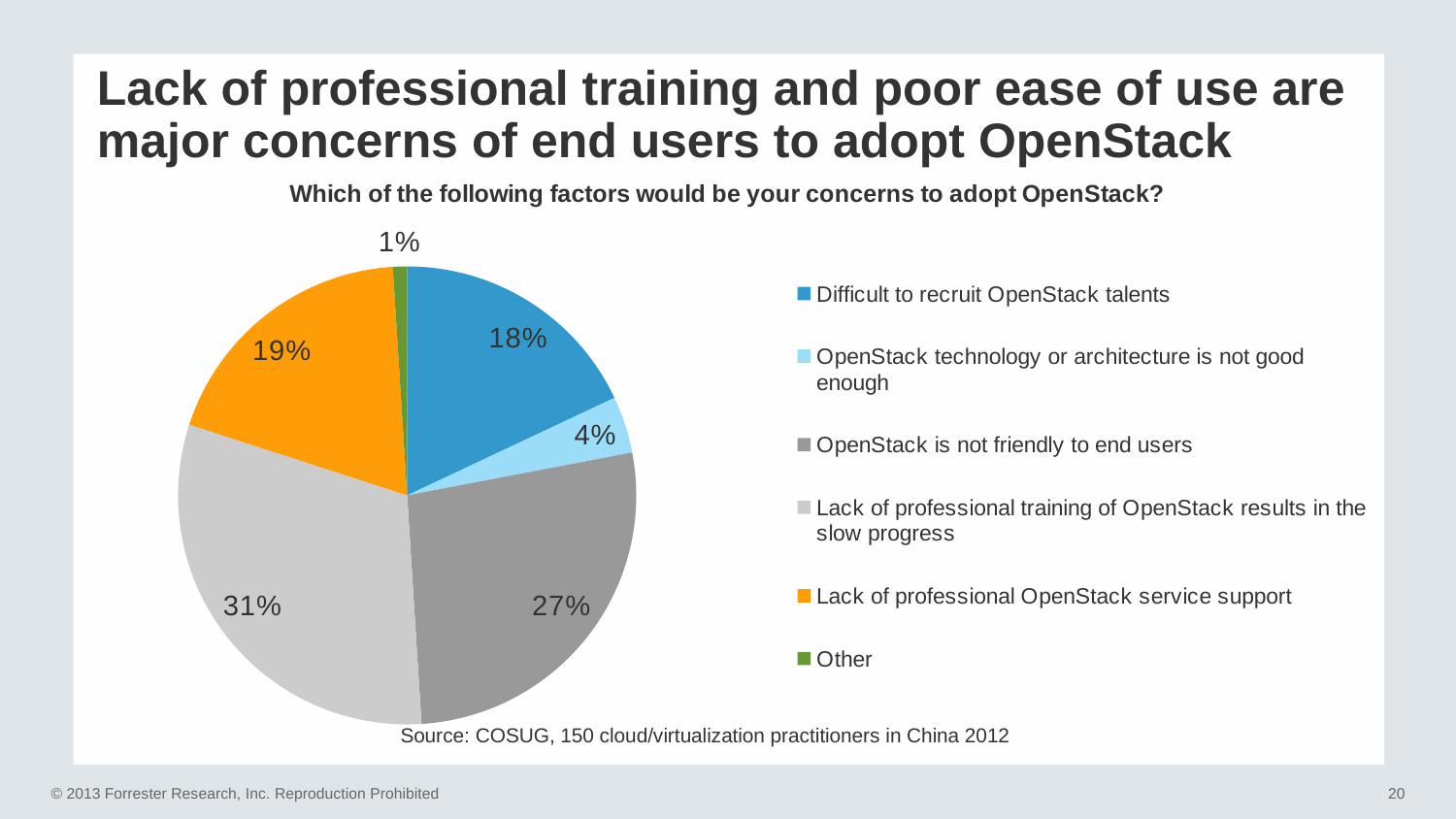
What share of respondents cited "Lack of professional OpenStack service support"? 19% How many slices does the pie chart have? 6 What colour is the slice for "Lack of professional OpenStack service support"? Orange Which is larger: the share for "Lack of professional OpenStack service support" or the share for "Difficult to recruit OpenStack talents"? Lack of professional OpenStack service support What share of respondents cited "OpenStack is not friendly to end users"? 27% What is the difference in percentage points between "Lack of professional training of OpenStack results in the slow progress" and "OpenStack is not friendly to end users"? 4 percentage points What share of respondents cited "Difficult to recruit OpenStack talents"? 18% What kind of chart is shown on the slide? Pie chart Which concern has the largest slice of the pie? Lack of professional training of OpenStack results in the slow progress Which concern has the smallest slice of the pie? Other